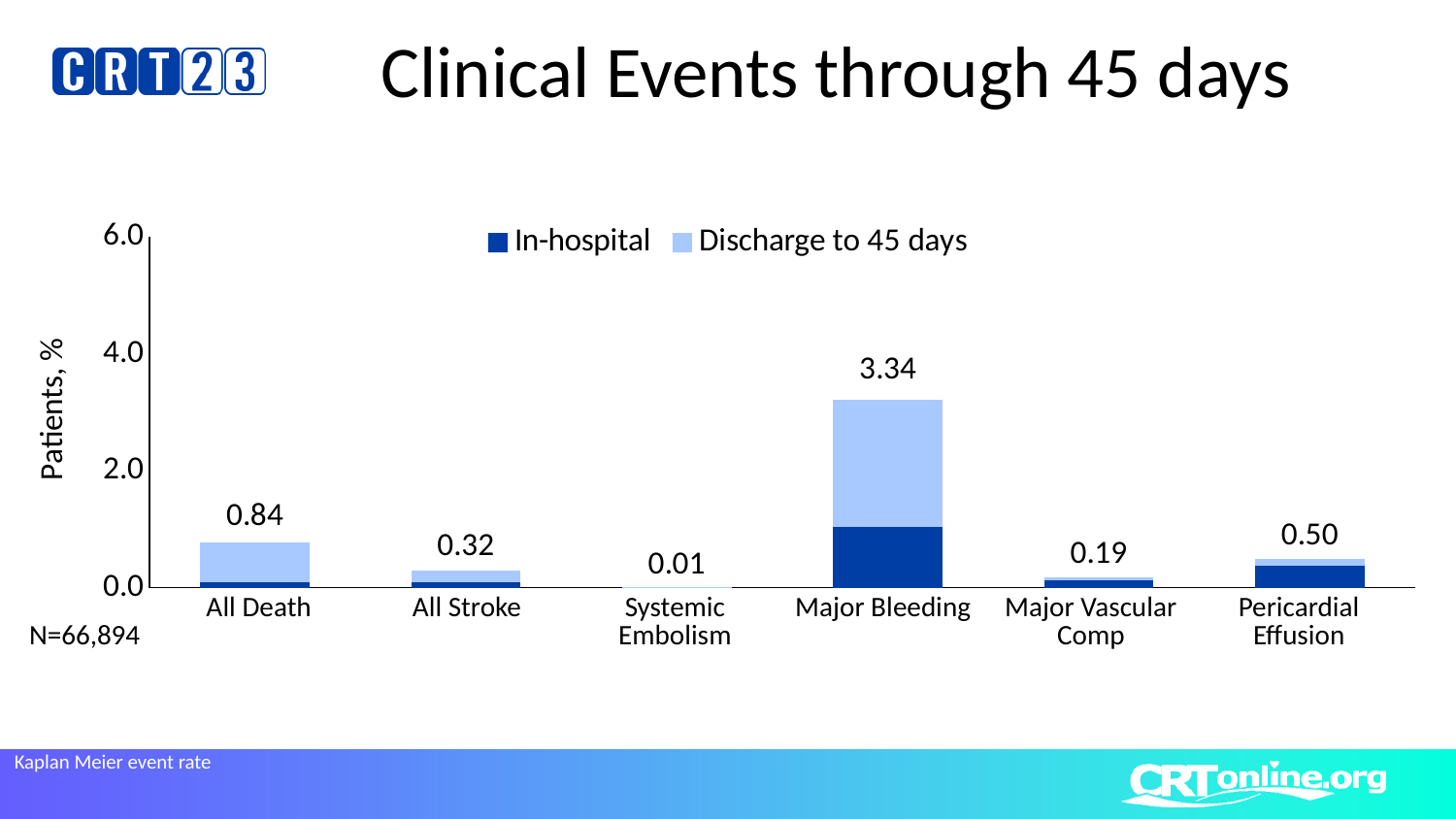
What is the value shown for Systemic Embolism? 0.01 What is the total event rate shown for Major Bleeding? 3.34 What is the value shown for Pericardial Effusion? 0.50 Which clinical event has the highest rate? Major Bleeding How many clinical event categories are shown on the x axis? 6 Which is larger, the rate for All Stroke or the rate for Major Vascular Comp? All Stroke Which clinical event has the lowest rate? Systemic Embolism How many series does the legend list? 2 Is the total value for Major Bleeding greater or less than 2.0? greater What is the value labeled above the All Death bar? 0.84 What type of chart is shown on the slide? Stacked bar chart What is the difference between the Major Bleeding rate and the All Death rate? 2.50